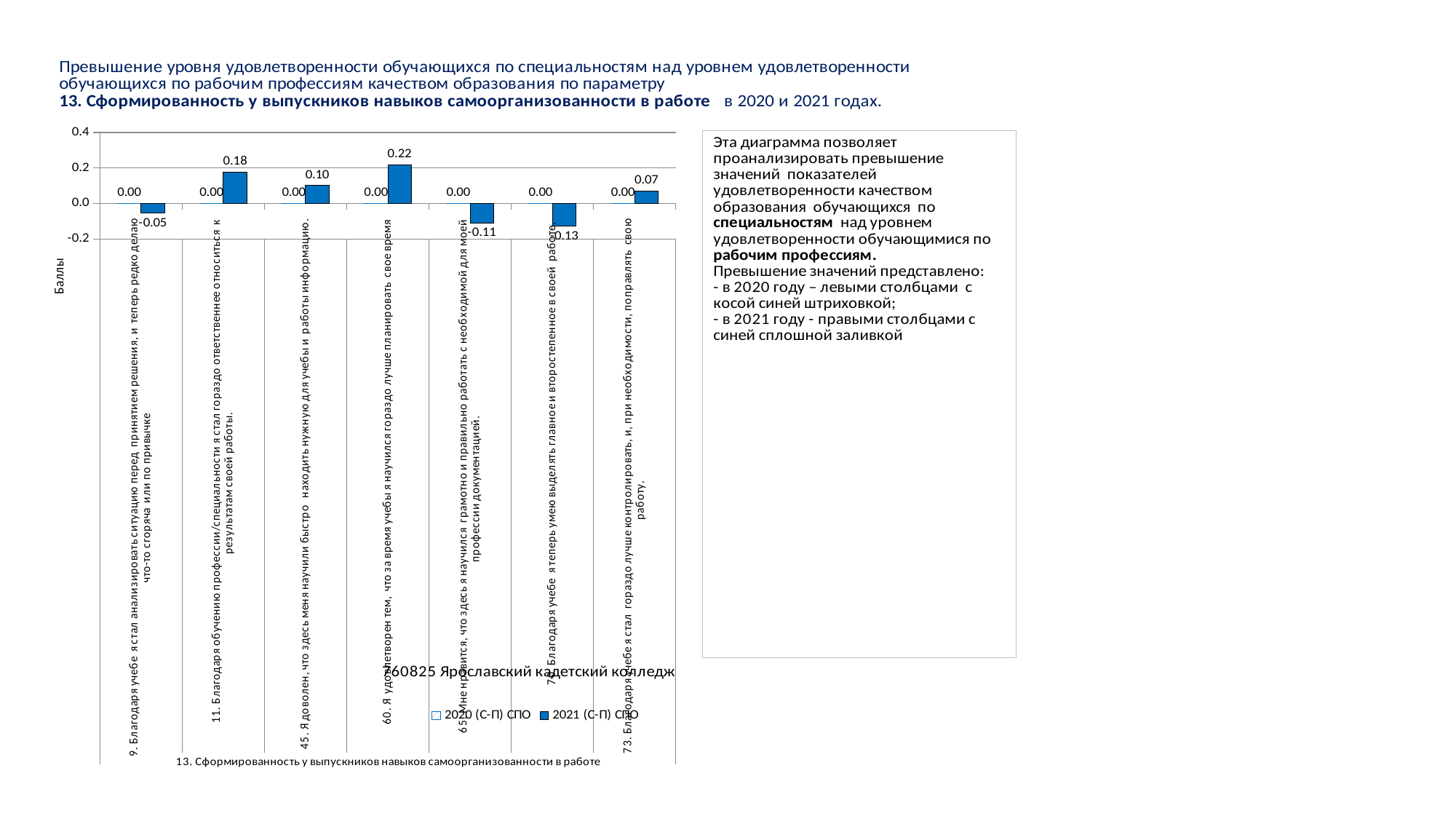
What is the difference between the 2021 (С-П) СПО values for statement 60 and statement 11? 0.04 What is the 2021 (С-П) СПО value for statement 11 ("Благодаря обучению профессии/специальности я стал гораздо ответственнее относиться к результатам своей работы")? 0.18 Which has the larger 2021 (С-П) СПО value: statement 45 or statement 73? statement 45 What is the 2021 (С-П) СПО value for statement 60 ("Я удовлетворен тем, что за время учебы я научился гораздо лучше планировать свое время")? 0.22 Which statement has the highest 2021 (С-П) СПО value? 60. Я удовлетворен тем, что за время учебы я научился гораздо лучше планировать свое время What is the 2020 (С-П) СПО value for statement 9 ("Благодаря учебе я стал анализировать ситуацию перед принятием решения...")? 0.00 What is the lowest 2021 (С-П) СПО value shown on the chart? -0.13 How many statement categories are plotted along the x axis? 7 What are the two legend entries of the chart? 2020 (С-П) СПО and 2021 (С-П) СПО How many series does the chart legend list? 2 What kind of chart is shown on the slide? bar chart What is the 2021 (С-П) СПО value for statement 65 ("Мне нравится, что здесь я научился грамотно и правильно работать с необходимой для моей профессии документацией")? -0.11